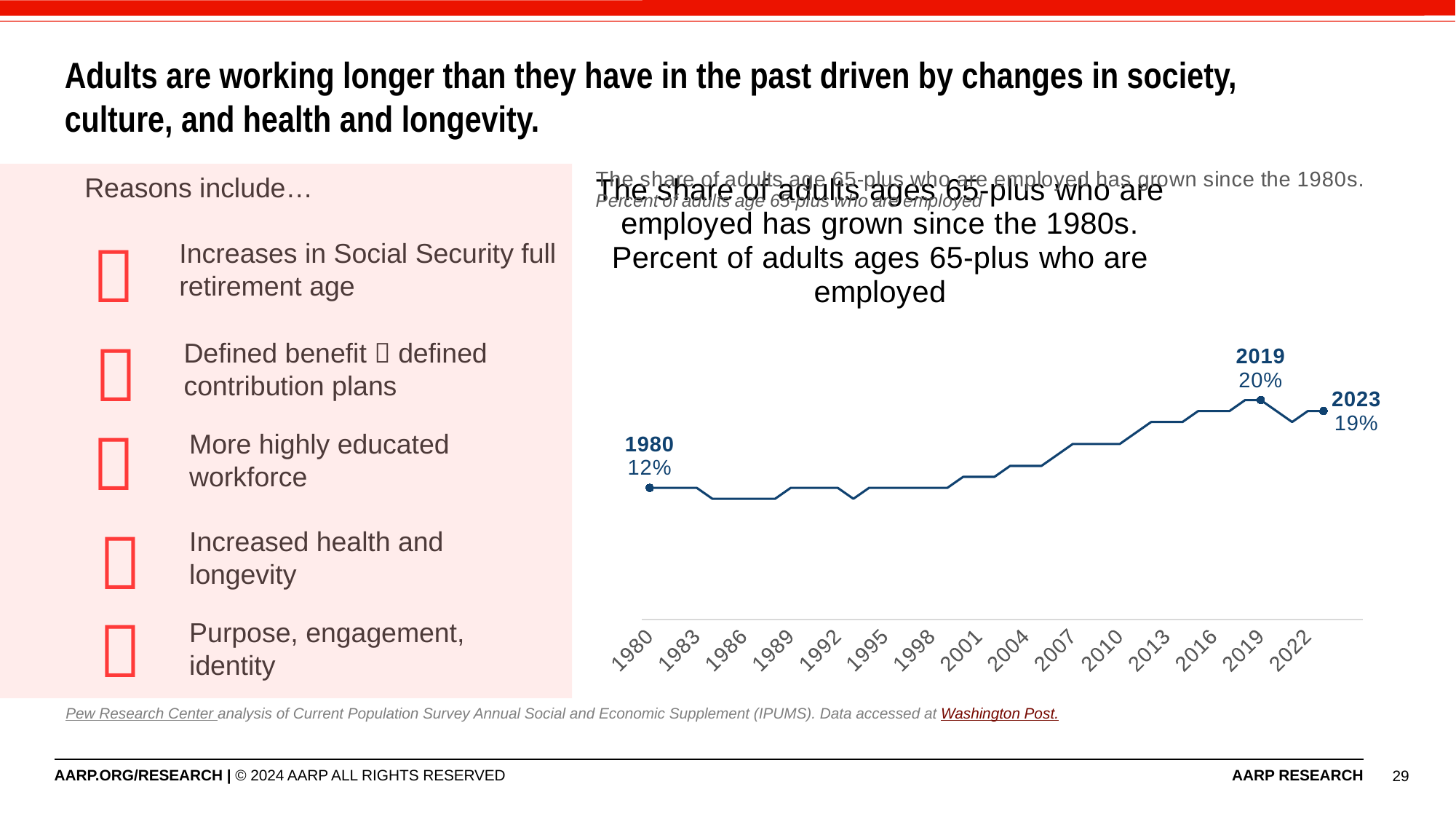
By how many percentage points did the share of employed adults ages 65-plus grow from 1980 to 2019? 8 percentage points Which year has a larger share of employed adults ages 65-plus, 1980 or 2023? 2023 What is the percent of adults ages 65-plus who are employed in 2023? 19% By how many percentage points did the share of employed adults ages 65-plus change from 2019 to 2023? 1 percentage point What is the percent of adults ages 65-plus who are employed in 2019? 20% What is the percent of adults ages 65-plus who are employed in 1980? 12% Of the labeled years on the chart, which has the highest share of adults ages 65-plus who are employed? 2019 Which year has a larger share of employed adults ages 65-plus, 2019 or 2023? 2019 How many year labels are shown on the x axis of the chart? 15 Overall, does the share of employed adults ages 65-plus rise or fall from 1980 to 2023? Rise What kind of chart is shown on the slide? Line chart What is the first year label on the x axis of the chart? 1980